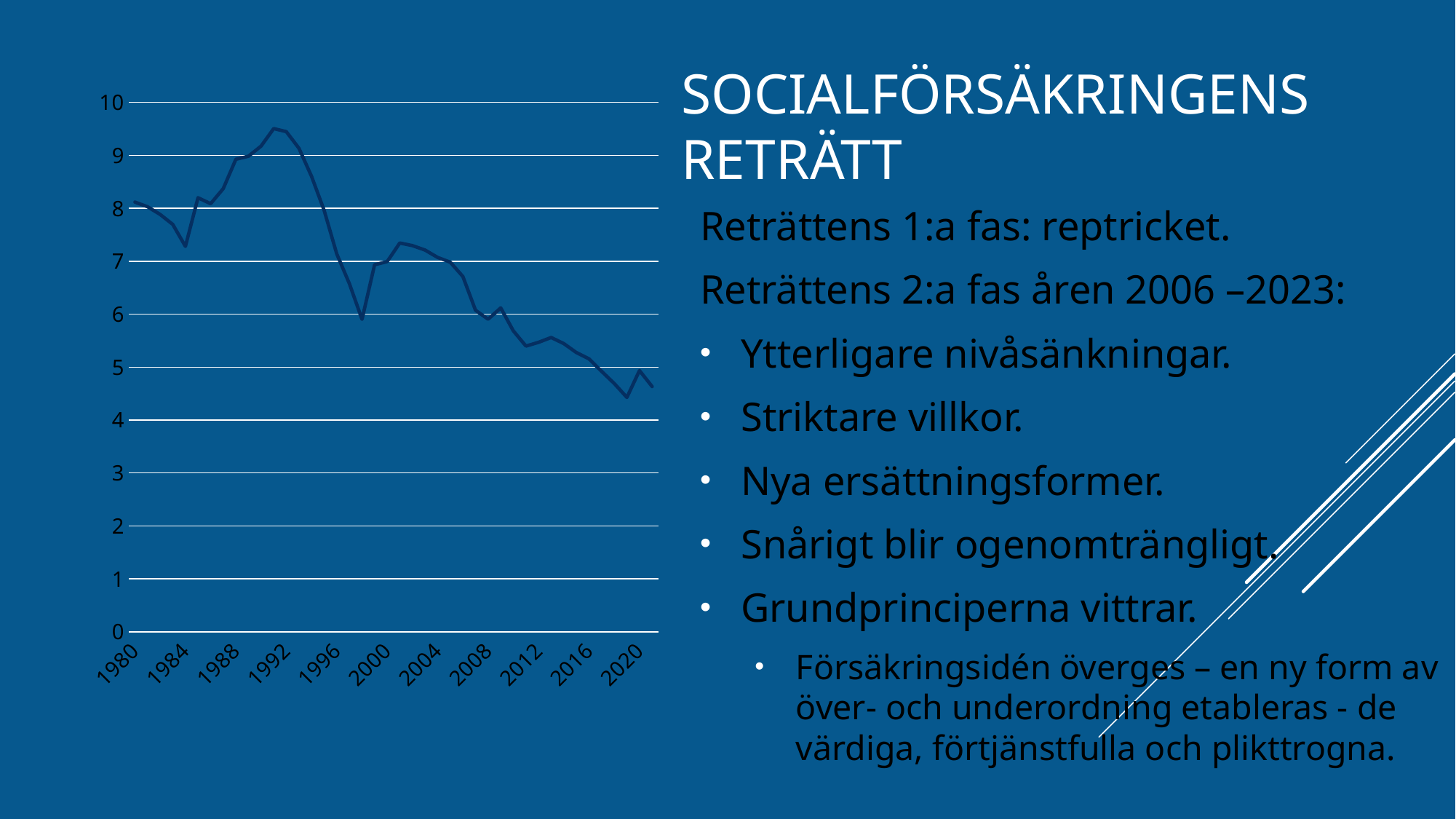
How many year labels are shown on the x axis? 11 What kind of chart is shown on the left of the slide? line chart What is the highest value shown on the y axis? 10 Is the value for 2016 greater or less than 6? less Is the value for 1992 greater or less than 9? greater Overall, does the line rise or fall from 1980 to 2020? fall Is the value for 2008 greater or less than 7? less Which year has the larger value, 1980 or 2016? 1980 Which year has the larger value, 1992 or 2020? 1992